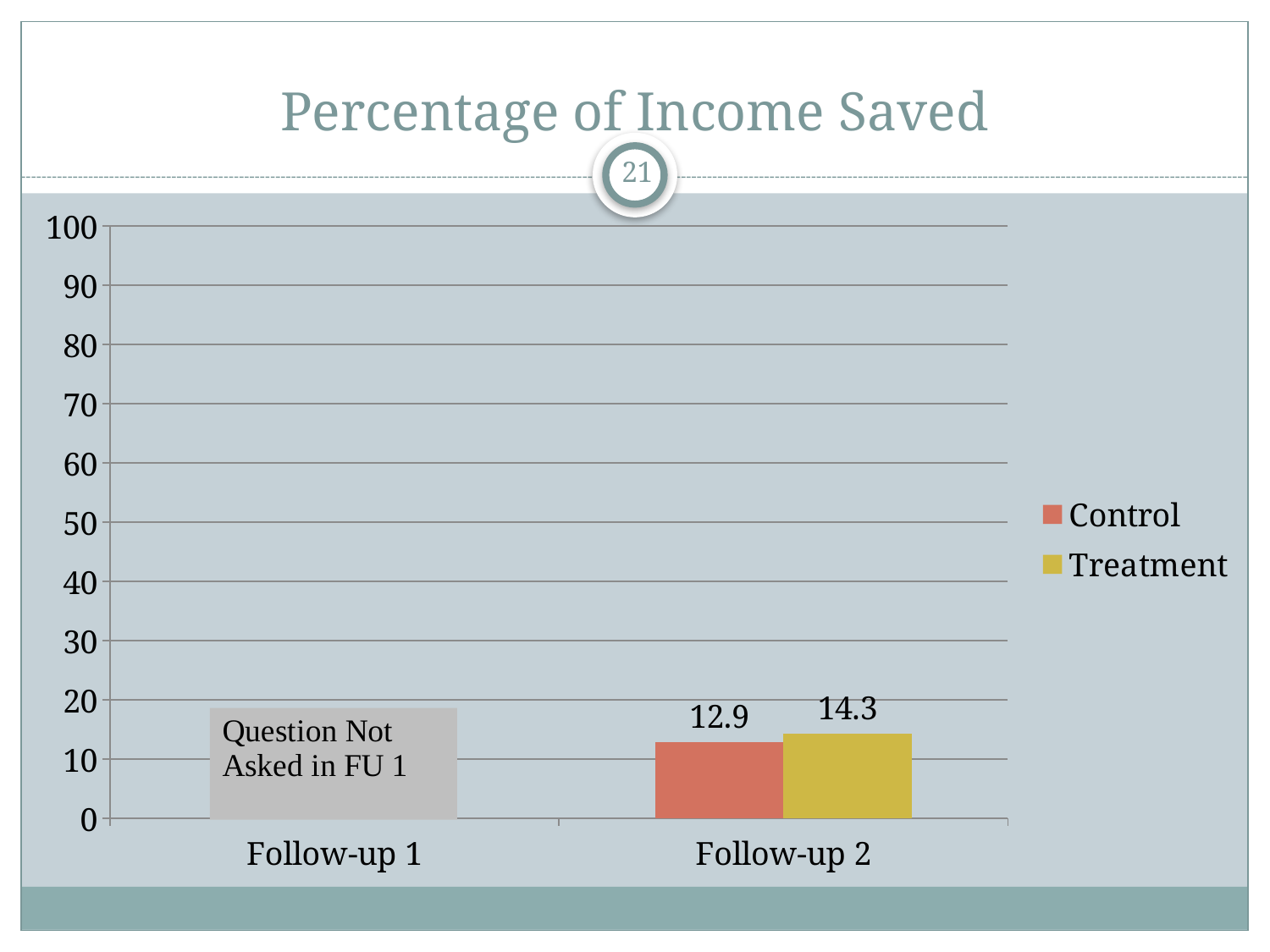
What kind of chart is shown on the slide? bar chart What is the Treatment value for Follow-up 2? 14.3 How many series does the legend list? 2 How many categories are shown on the x axis? 2 Is the Treatment value for Follow-up 2 greater or less than 20? less What is the difference between the Treatment and Control values for Follow-up 2? 1.4 What is the title of the chart? Percentage of Income Saved Is the Control value for Follow-up 2 greater or less than 10? greater Which series has the higher value for Follow-up 2, Control or Treatment? Treatment What does the grey box over Follow-up 1 say? Question Not Asked in FU 1 What is the Control value for Follow-up 2? 12.9 What is the maximum value shown on the y axis? 100